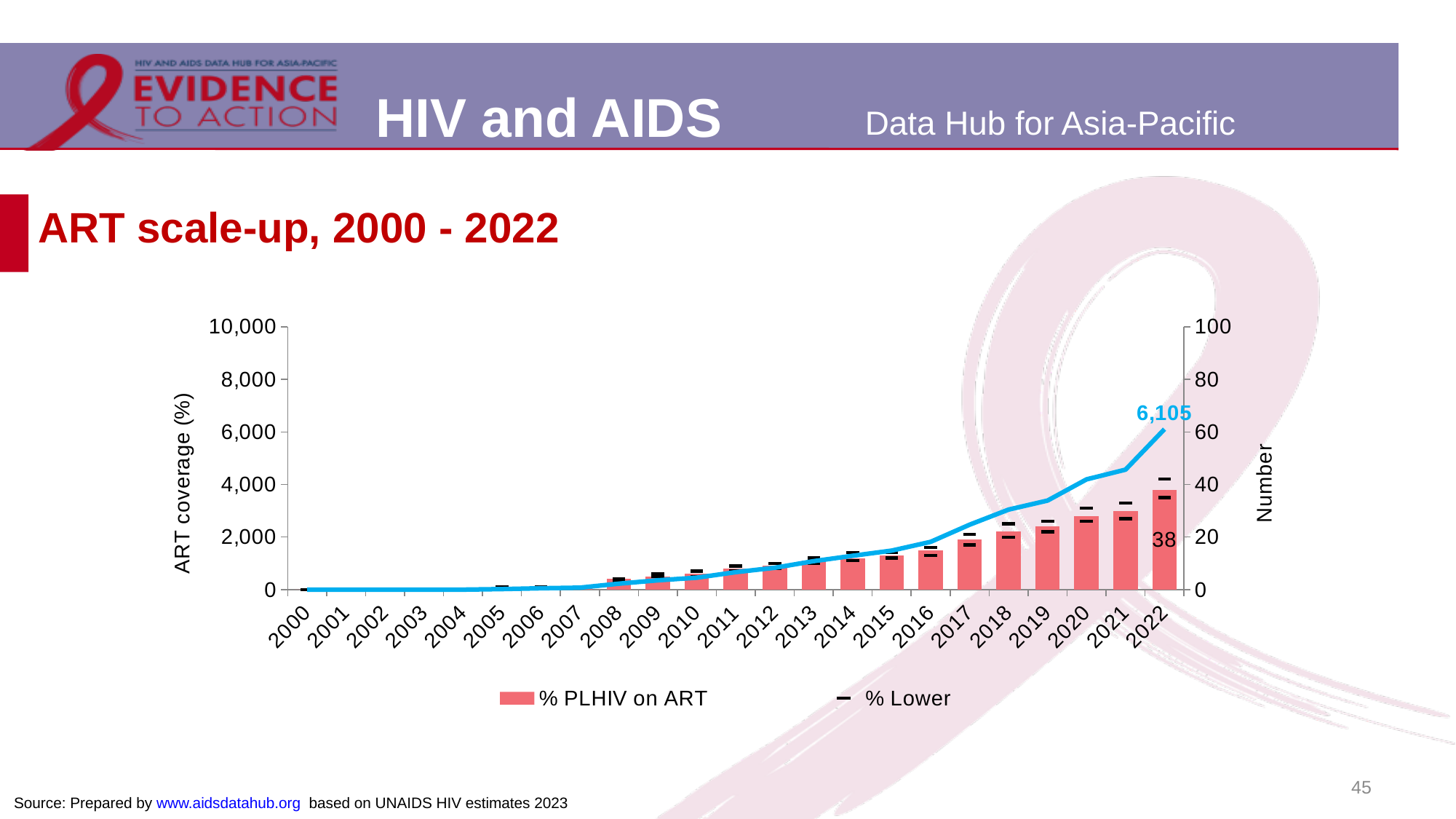
Is the % PLHIV on ART bar for 2021 greater or less than 40 on the right axis? less What is the title of the chart on the slide? ART scale-up, 2000 - 2022 Which year has the highest % PLHIV on ART bar? 2022 Which year has the larger % PLHIV on ART bar, 2015 or 2022? 2022 What is the % PLHIV on ART value labelled on the bar for 2022? 38 What kind of chart is shown on the slide? Bar chart combined with a line What are the two entries listed in the chart's legend? % PLHIV on ART and % Lower How many series does the chart's legend list? 2 Is the blue line value for 2018 greater or less than 4,000 on the left axis? less How many years are shown along the x axis of the chart? 23 Do the % PLHIV on ART bars generally rise or fall from 2000 to 2022? Rise What value is labelled on the blue line for 2022? 6,105